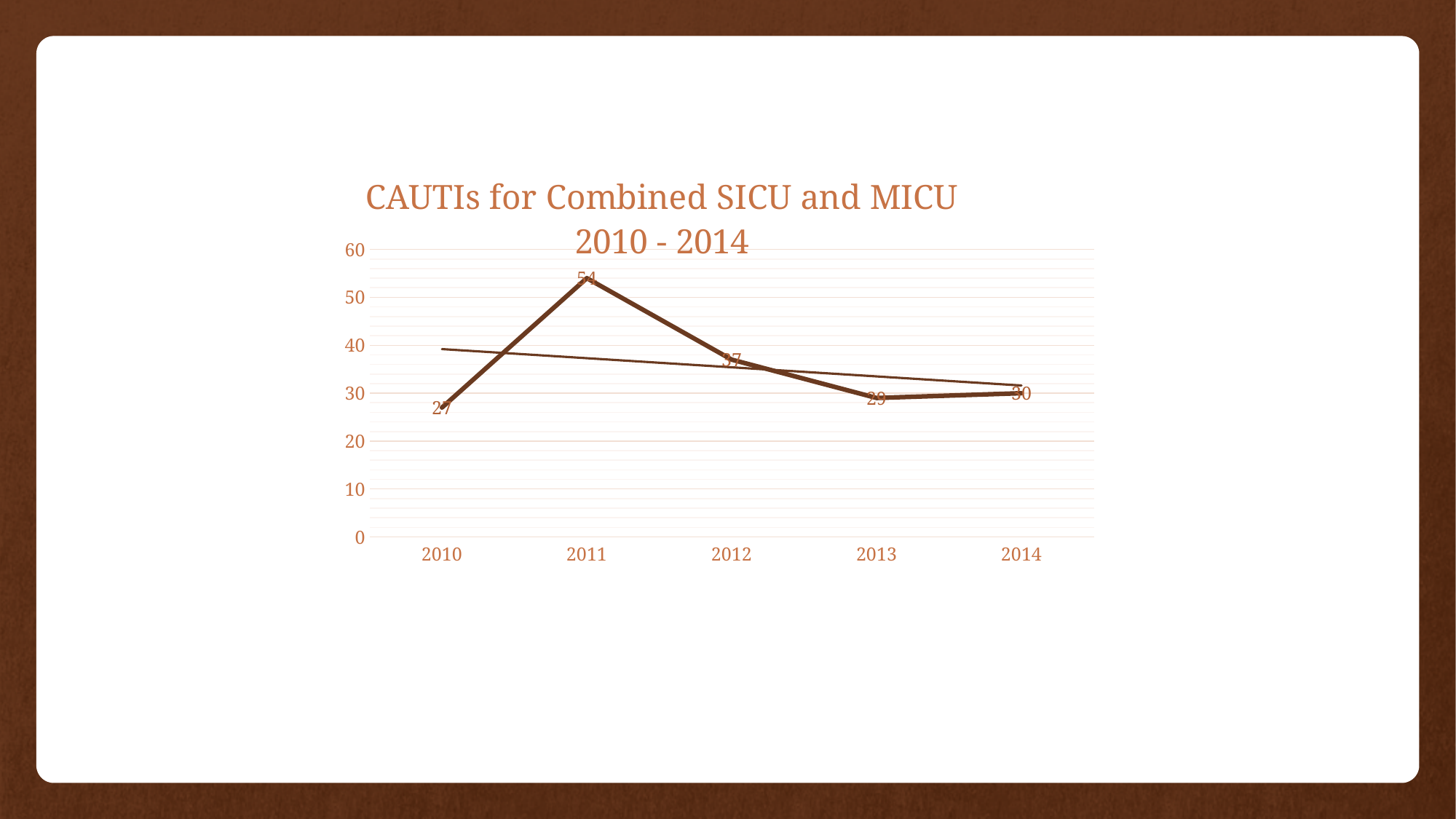
What is the difference between the values for 2011 and 2012? 17 Is the value for 2011 greater or less than 50? greater What kind of chart is this? line chart How many years are plotted on the x axis? 5 Which year has the highest value? 2011 Which is larger, the value for 2010 or the value for 2012? 2012 What is the value for 2011? 54 What is the value for 2014? 30 What is the value for 2010? 27 What is the value for 2013? 29 Which year has the lowest value? 2010 What is the title of the chart? CAUTIs for Combined SICU and MICU 2010 - 2014